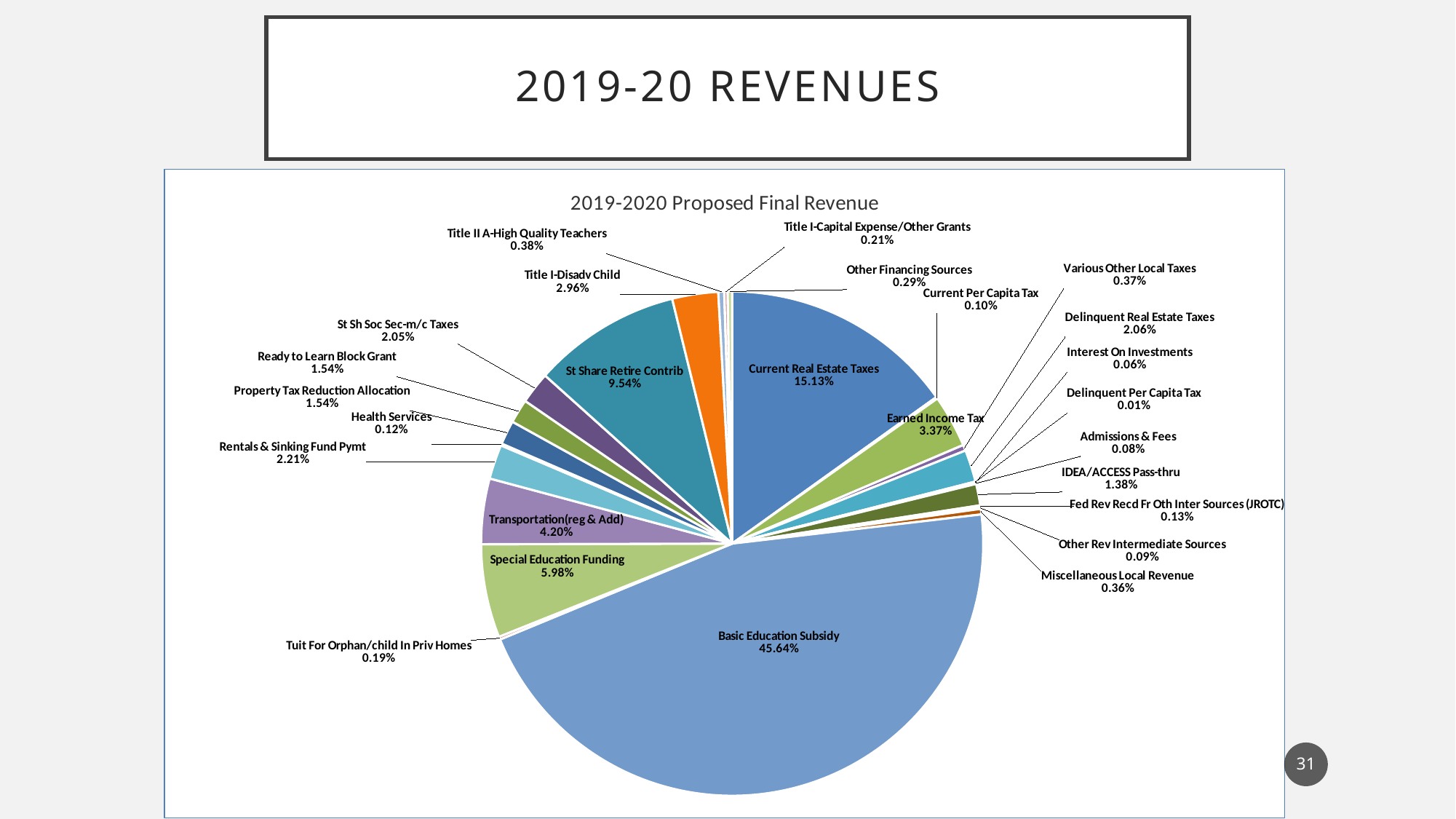
Which category has the largest slice of the pie? Basic Education Subsidy What is the difference in percentage points between Basic Education Subsidy and Current Real Estate Taxes? 30.51 Which category has the smallest percentage? Delinquent Per Capita Tax Which is larger, Special Education Funding or Transportation(reg & Add)? Special Education Funding What is the title of the chart? 2019-2020 Proposed Final Revenue What percentage is shown for Current Real Estate Taxes? 15.13% How many categories are shown in the pie chart? 26 What share of revenue does Basic Education Subsidy represent? 45.64% What is the difference in percentage points between Special Education Funding and Transportation(reg & Add)? 1.78 What percentage is shown for St Share Retire Contrib? 9.54% What percentage is shown for Earned Income Tax? 3.37% What type of chart is shown on the slide? Pie chart